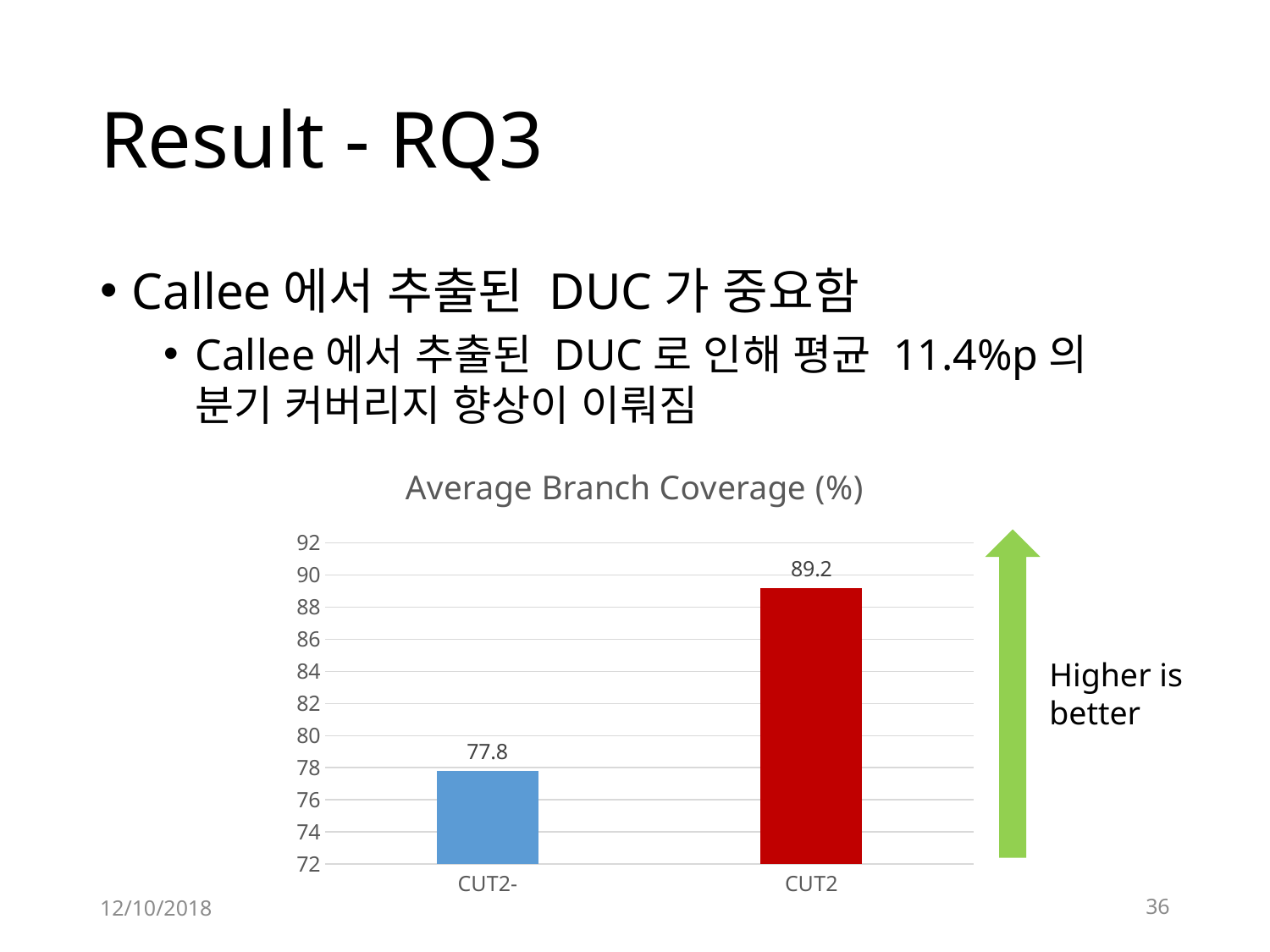
Is the value for CUT2- greater or less than 80? less What is the title of the chart? Average Branch Coverage (%) What colour is the bar for CUT2? red Which category has the lowest average branch coverage? CUT2- What is the average branch coverage for CUT2-? 77.8 What is the difference in average branch coverage between CUT2 and CUT2-? 11.4 What is the average branch coverage for CUT2? 89.2 What kind of chart is shown on the slide? bar chart Is the value for CUT2 greater or less than 88? greater How many categories are shown in the chart? 2 Which category has the highest average branch coverage? CUT2 Which has a larger average branch coverage, CUT2- or CUT2? CUT2